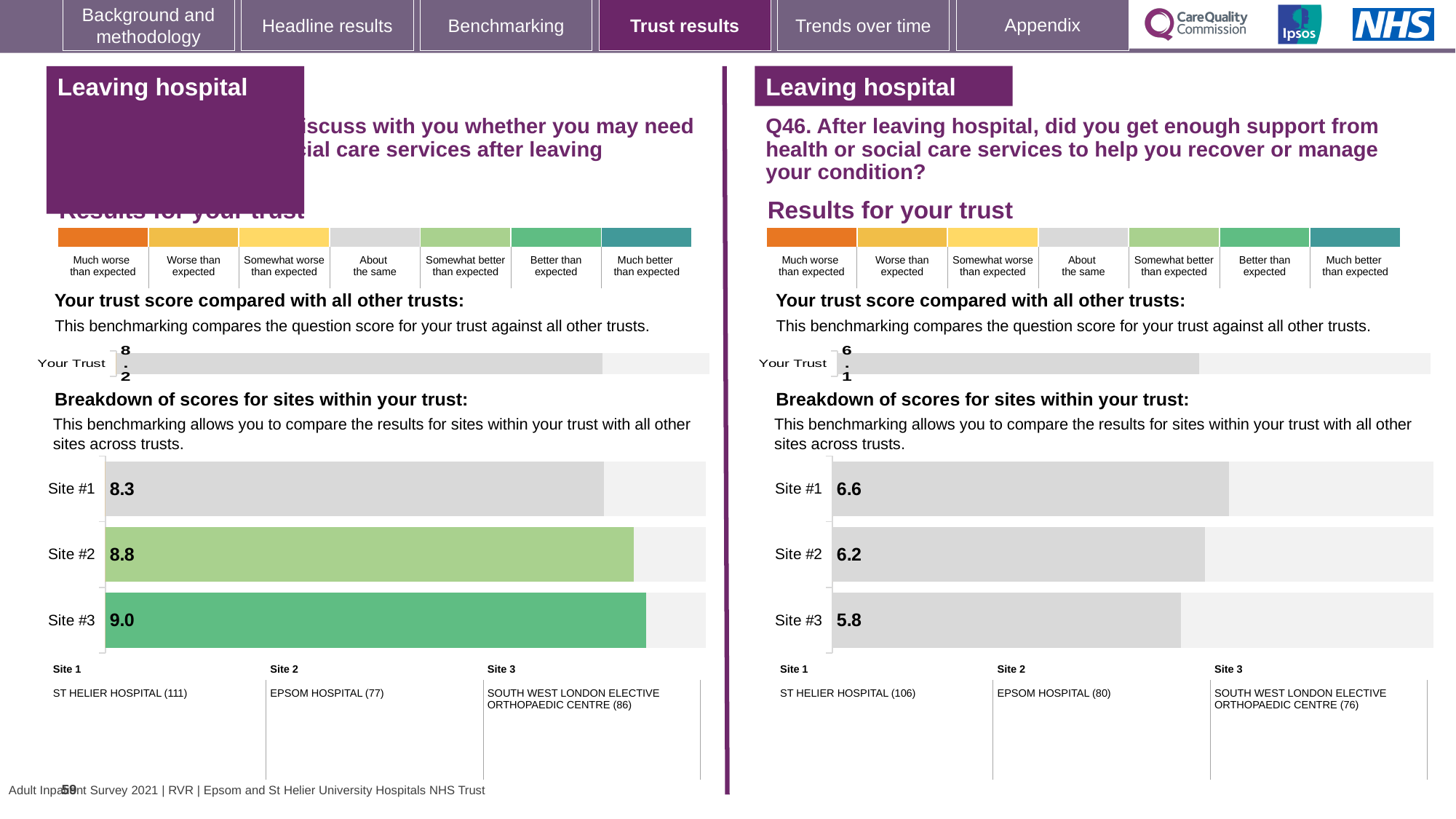
In the right-hand Q46 'Breakdown of scores for sites within your trust' chart, how many sites are shown? 3 In the left-hand 'Breakdown of scores for sites within your trust' chart, which site has the highest score? Site #3 In the right-hand Q46 'Breakdown of scores for sites within your trust' chart, what is the score for Site #2? 6.2 In the right-hand Q46 'Your trust score compared with all other trusts' chart, what is the score for Your Trust? 6.1 In the left-hand 'Breakdown of scores for sites within your trust' chart, is the score for Site #2 larger or smaller than the score for Site #1? Larger In the left-hand 'Your trust score compared with all other trusts' chart, what is the score for Your Trust? 8.2 In the right-hand Q46 'Breakdown of scores for sites within your trust' chart, which site has the highest score? Site #1 In the right-hand Q46 'Breakdown of scores for sites within your trust' chart, what is the difference between the scores for Site #1 and Site #3? 0.8 What type of chart is the left-hand 'Breakdown of scores for sites within your trust' chart? Bar chart In the left-hand 'Breakdown of scores for sites within your trust' chart, what is the score for Site #1? 8.3 In the right-hand Q46 'Breakdown of scores for sites within your trust' chart, which site has the lowest score? Site #3 In the left-hand 'Breakdown of scores for sites within your trust' chart, what is the difference between the scores for Site #3 and Site #1? 0.7